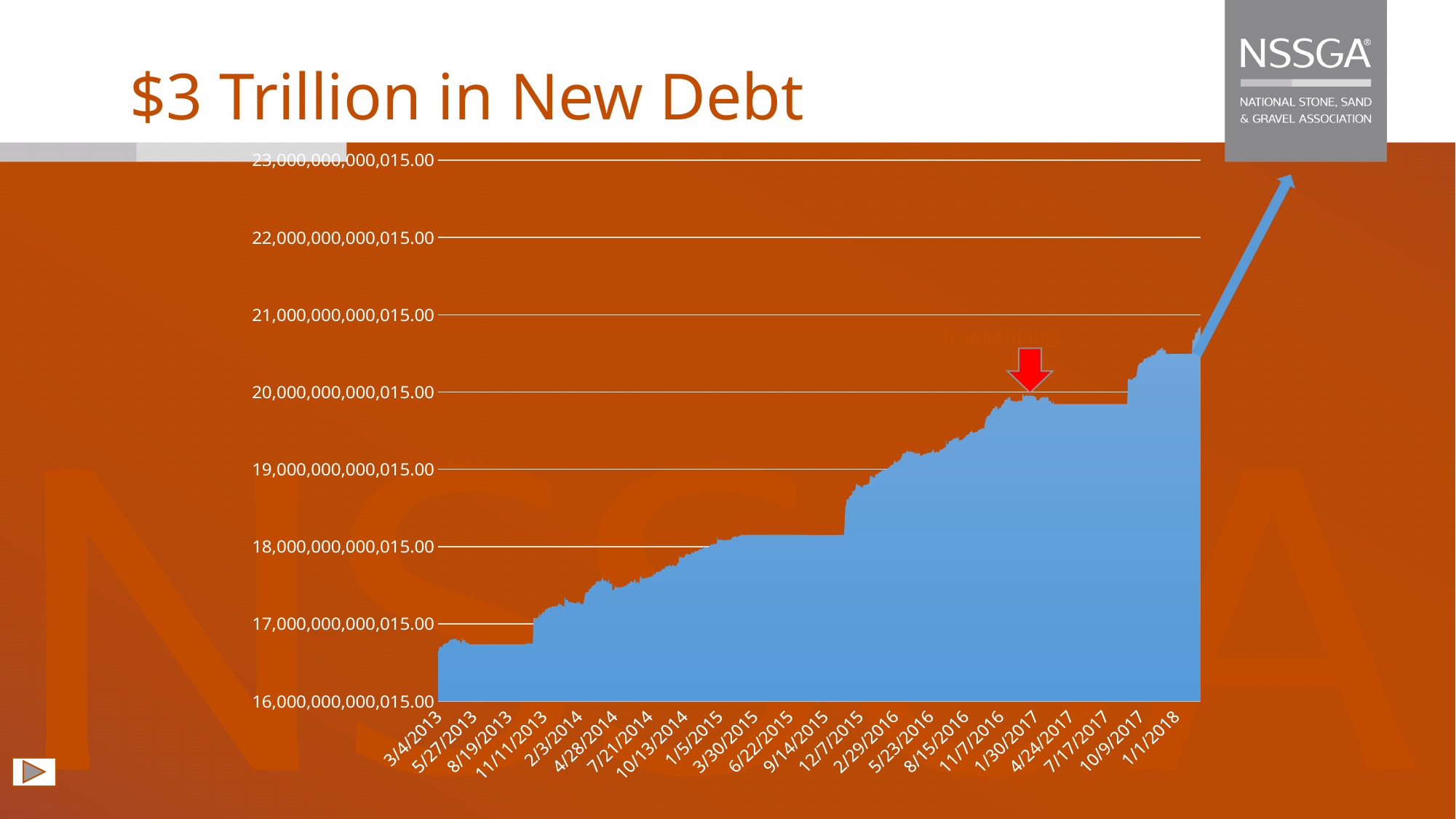
Is the value at 5/23/2016 greater or less than 19,000,000,000,015.00? greater What is the title of the slide containing the chart? $3 Trillion in New Debt Is the value at 10/9/2017 greater or less than 20,000,000,000,015.00? greater Which of the two dates has the larger value, 1/5/2015 or 11/7/2016? 11/7/2016 Is the value at 1/1/2018 greater or less than 20,000,000,000,015.00? greater Do the plotted values generally rise or fall from 3/4/2013 to 1/1/2018? Rise Which of the two dates has the larger value, 3/4/2013 or 1/1/2018? 1/1/2018 What kind of chart is shown on the slide? Area chart What is the highest value shown on the vertical axis? 23,000,000,000,015.00